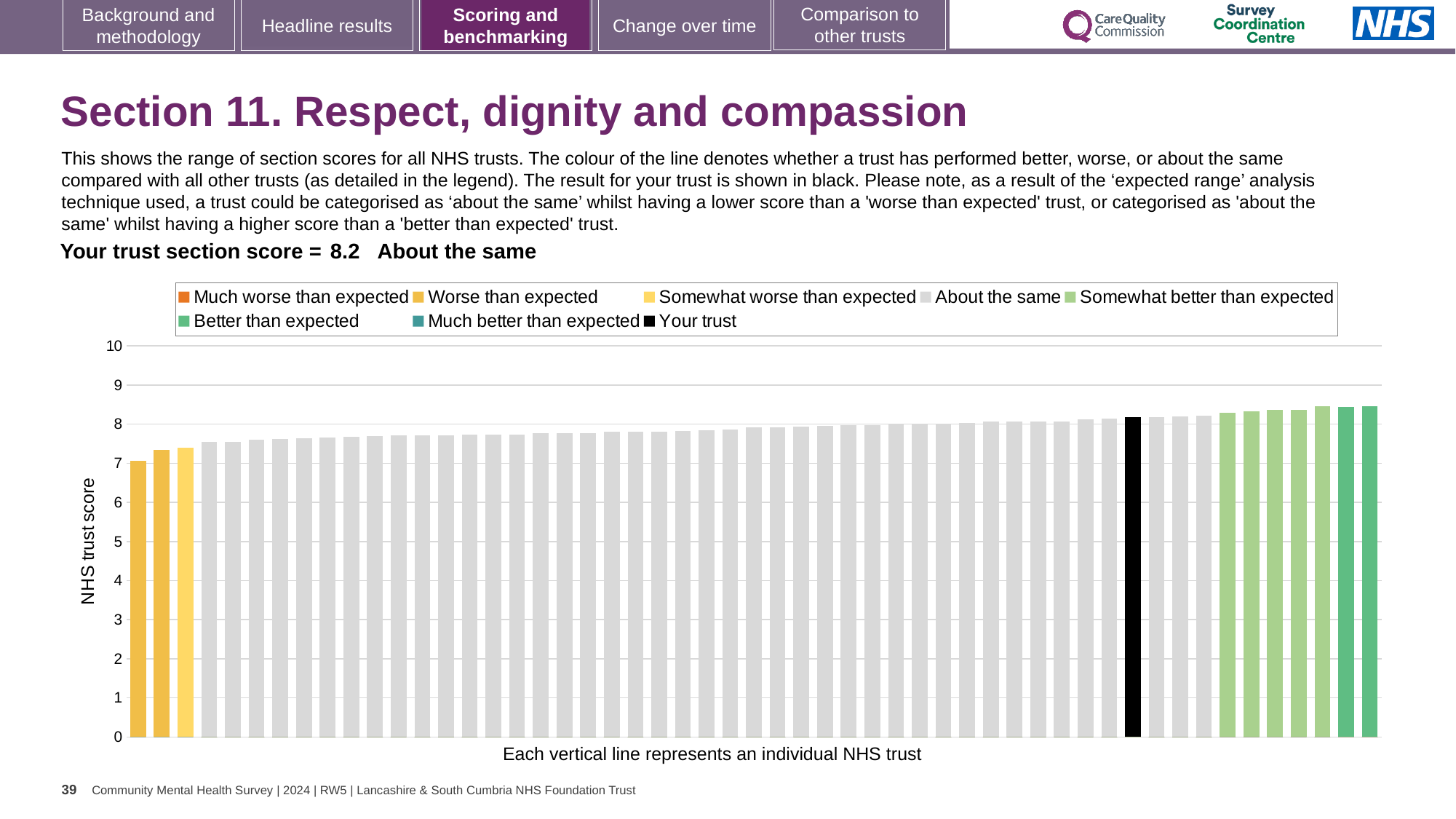
Which performance category is your trust placed in for Section 11? About the same What is the label on the y axis of the chart? NHS trust score How many entries does the chart legend list? 8 What colour is the bar representing your trust? Black Is the value for your trust (the black bar) greater or less than 8? greater What is the highest value shown on the y axis? 10 Is the value of the tallest bar greater or less than 9? less Is the value of the shortest bar greater or less than 8? less What kind of chart is used to show the NHS trust scores? Bar chart Do the trust scores rise or fall moving from left to right along the x axis? Rise How many bars are coloured as 'Better than expected' (the darker green)? 2 What is the section score for your trust shown on the slide? 8.2